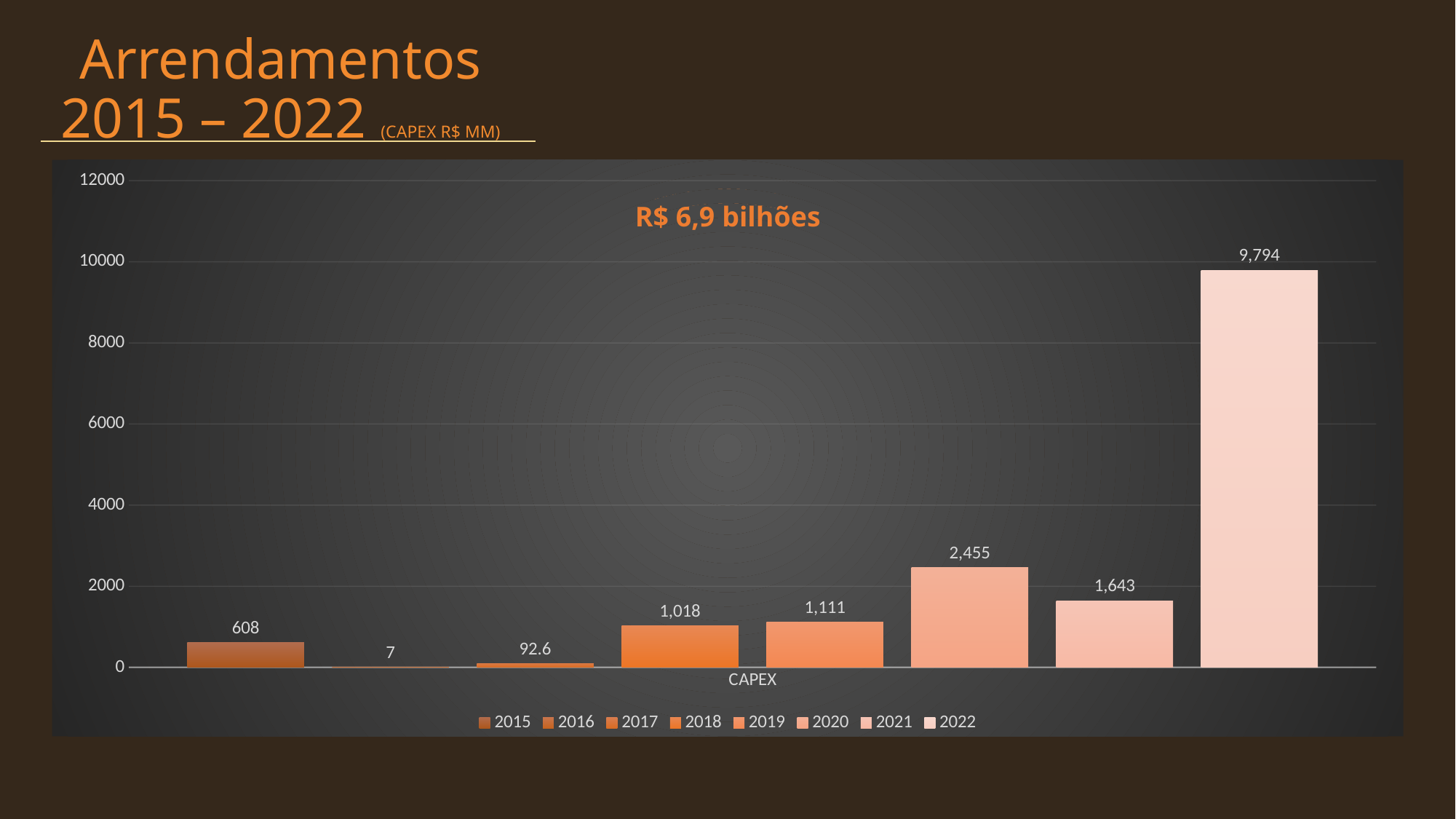
What is the CAPEX value for 2020? 2,455 What is the CAPEX value for 2017? 92.6 What is the CAPEX value for 2022? 9,794 What kind of chart is shown on the slide? bar chart Is the CAPEX value for 2021 greater or less than 2000? less Which is larger, the CAPEX value for 2018 or for 2019? 2019 What is the orange text shown inside the chart area above the bars? R$ 6,9 bilhões Which year has the highest CAPEX value? 2022 How many series does the legend list? 8 What is the CAPEX value for 2016? 7 What is the difference between the CAPEX values for 2020 and 2021? 812 Which year has the lowest CAPEX value? 2016